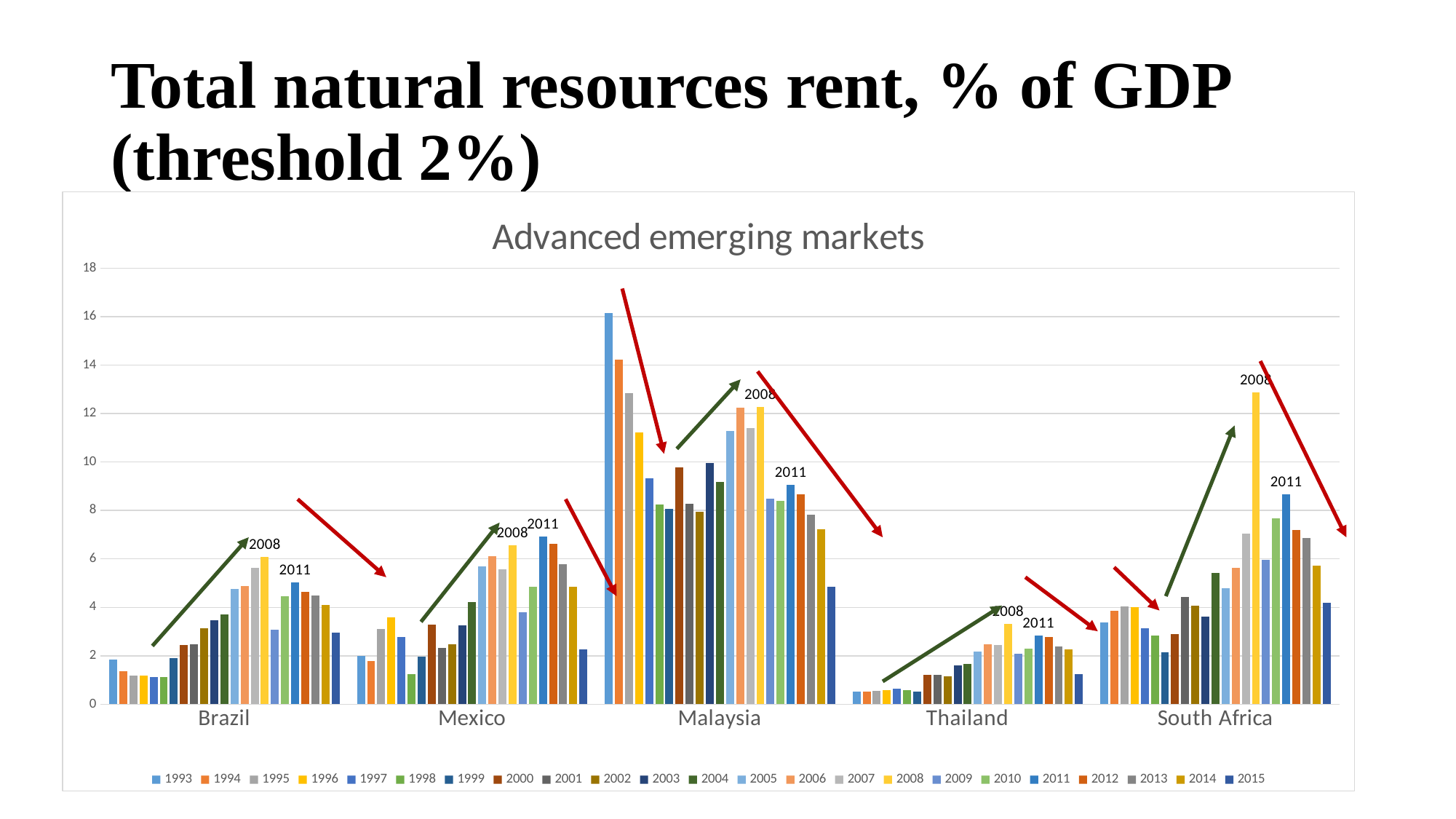
Is the value for South Africa in 2008 greater or less than 12? greater Is the value for Malaysia in 1993 greater or less than 14? greater Which country has the lowest bars overall in the chart? Thailand How many years (series) does the legend list? 23 What type of chart is shown on the slide? Bar chart Which is larger: the 1993 value for Malaysia or the 2008 value for South Africa? Malaysia Which is larger: the 2008 value for Thailand or the 2008 value for South Africa? South Africa What is the title of the chart? Advanced emerging markets Is the value for Mexico in 2011 greater or less than 8? less Which country has the tallest bar in the chart? Malaysia How many countries are shown on the x axis of the chart? 5